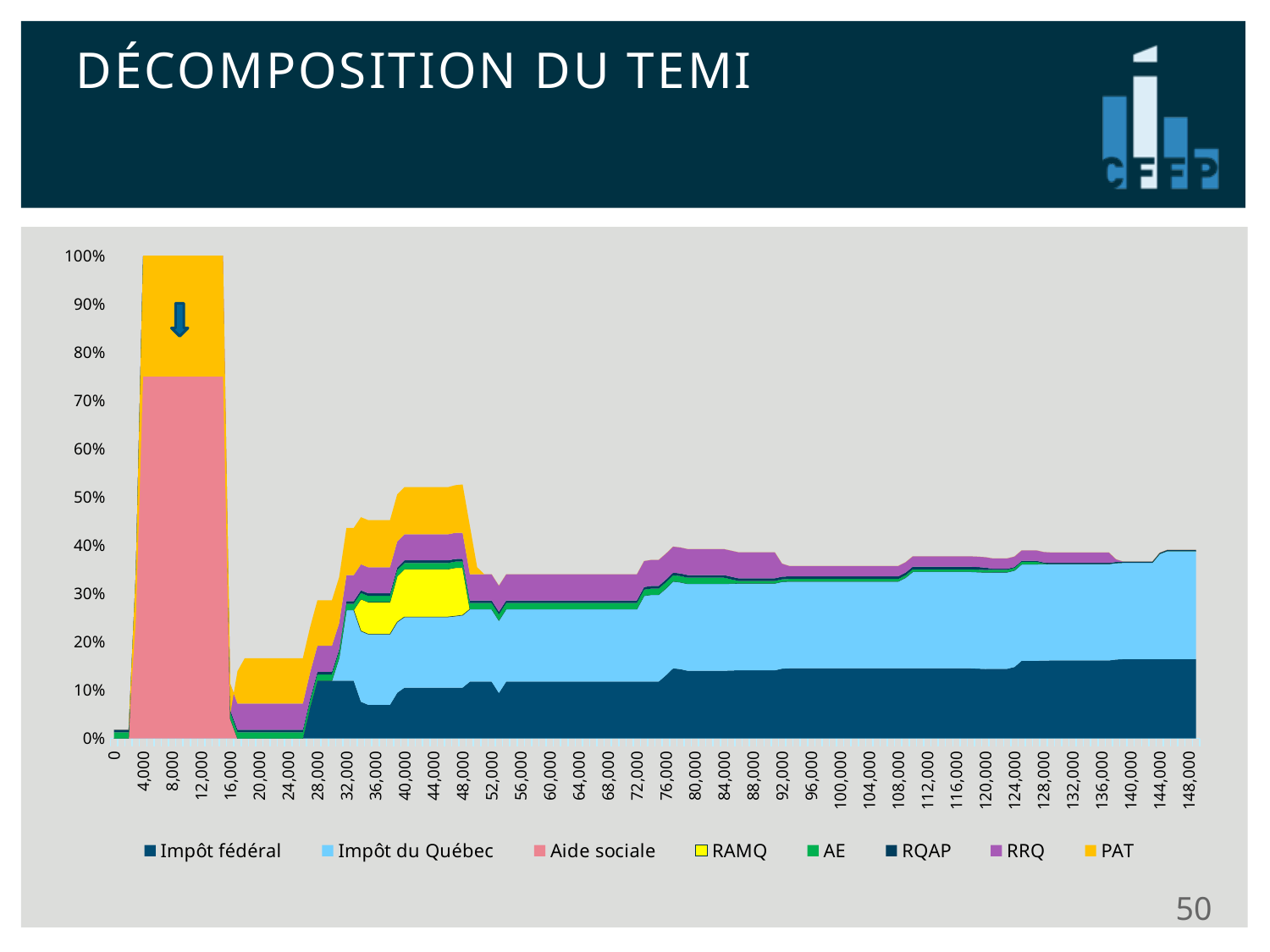
What kind of chart is shown on the slide? Stacked area chart Which series accounts for the largest share of the stack at an income of 100,000? Impôt du Québec Does the total stacked value rise or fall between incomes of 8,000 and 20,000? fall How many series does the legend list? 8 What is the title of the slide containing the chart? DÉCOMPOSITION DU TEMI What is the highest income value labelled on the x axis? 148,000 Is the total stacked value at an income of 20,000 greater or less than 20%? less Is the total stacked value at an income of 100,000 greater or less than 40%? less Which series is shown in pink in the legend? Aide sociale Is the total stacked value at an income of 44,000 greater or less than 40%? greater Which series accounts for the largest share of the stack at an income of 8,000? Aide sociale